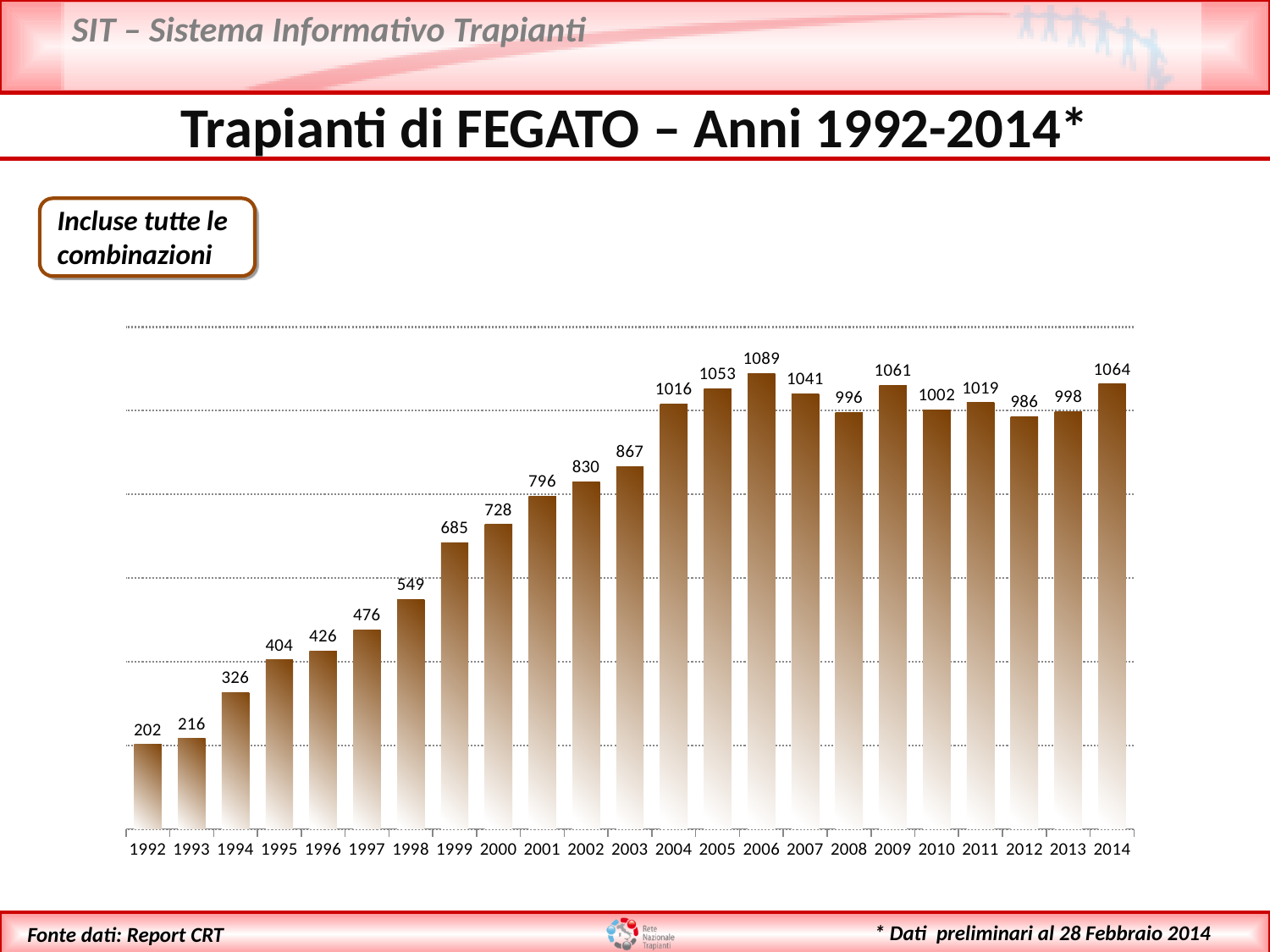
What is the value for 2014? 1064 What is the value for 1992? 202 How many years are shown on the x axis? 23 What kind of chart is shown on the slide? bar chart What is the difference between the values for 2006 and 2005? 36 Do the values generally rise or fall from 1992 to 2006? rise What is the value for 2006? 1089 Which year has the lowest value? 1992 What is the value for 1999? 685 Which is larger, the value for 2009 or the value for 2010? 2009 Which year has the highest value? 2006 What is the difference between the values for 2014 and 1992? 862